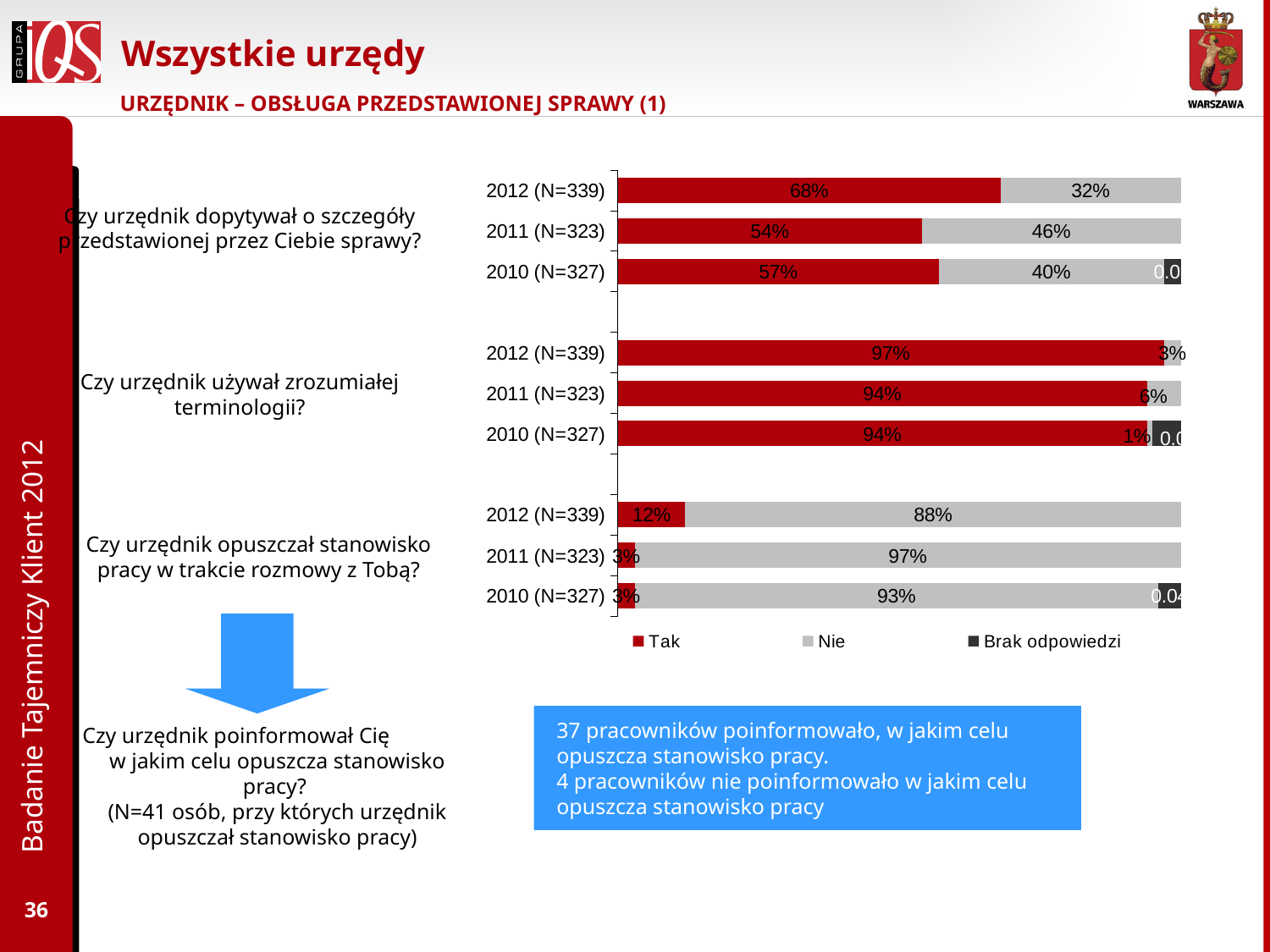
For the question 'Czy urzędnik dopytywał o szczegóły przedstawionej przez Ciebie sprawy?', what is the 'Nie' value for 2011 (N=323)? 46% For the question 'Czy urzędnik opuszczał stanowisko pracy w trakcie rozmowy z Tobą?', what is the 'Tak' value for 2011 (N=323)? 3% For the question 'Czy urzędnik opuszczał stanowisko pracy w trakcie rozmowy z Tobą?', what is the 'Nie' value for 2012 (N=339)? 88% For the question 'Czy urzędnik dopytywał o szczegóły przedstawionej przez Ciebie sprawy?', which year has the highest 'Tak' value? 2012 (N=339) What kind of chart is shown on the slide? stacked bar chart How many series does the chart legend list? 3 For the question 'Czy urzędnik dopytywał o szczegóły przedstawionej przez Ciebie sprawy?', what is the 'Tak' value for 2012 (N=339)? 68% For the question 'Czy urzędnik opuszczał stanowisko pracy w trakcie rozmowy z Tobą?', which year has the highest 'Tak' value? 2012 (N=339) For the question 'Czy urzędnik używał zrozumiałej terminologii?', what is the 'Tak' value for 2012 (N=339)? 97% What are the legend entries of the chart? Tak, Nie, Brak odpowiedzi For the question 'Czy urzędnik dopytywał o szczegóły przedstawionej przez Ciebie sprawy?', what is the difference between the 'Tak' values for 2012 (N=339) and 2011 (N=323)? 14% For the question 'Czy urzędnik używał zrozumiałej terminologii?', is the 'Tak' value for 2011 (N=323) larger or smaller than the 'Tak' value for 2012 (N=339)? smaller